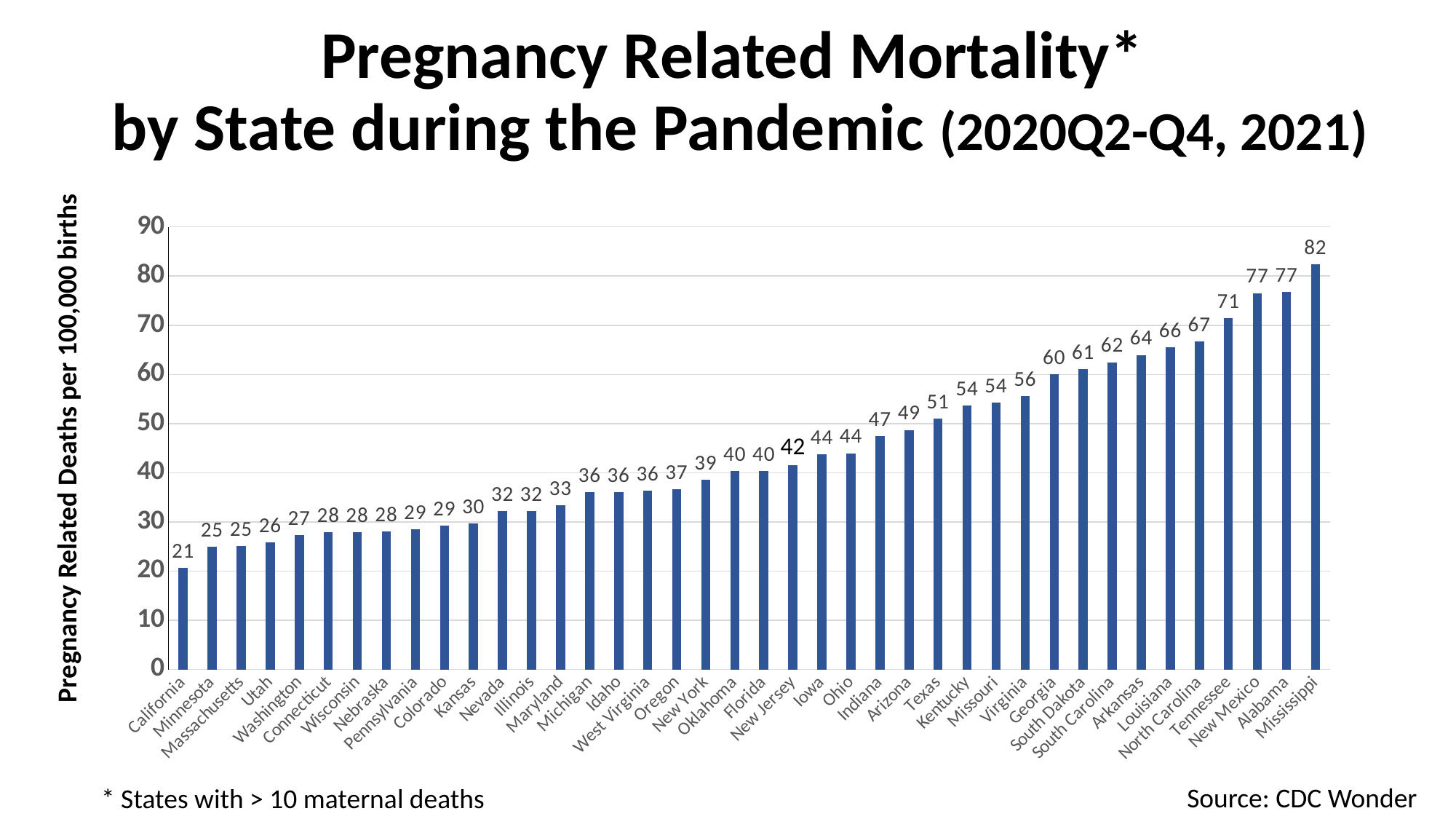
What is the value shown for New Jersey? 42 What kind of chart is shown on the slide? Bar chart What is the difference between the values for Georgia and Oregon? 23 Which state has the lowest pregnancy related mortality? California What is the pregnancy related mortality value for Texas? 51 What is the value shown for Tennessee? 71 Which has a higher value, Louisiana or Virginia? Louisiana What is the difference between the values for Mississippi and California? 61 Is the value for Arizona greater or less than 40? greater Which state has the highest pregnancy related mortality? Mississippi Do the values rise or fall moving from left to right along the x axis? Rise How many states are shown in the chart? 40